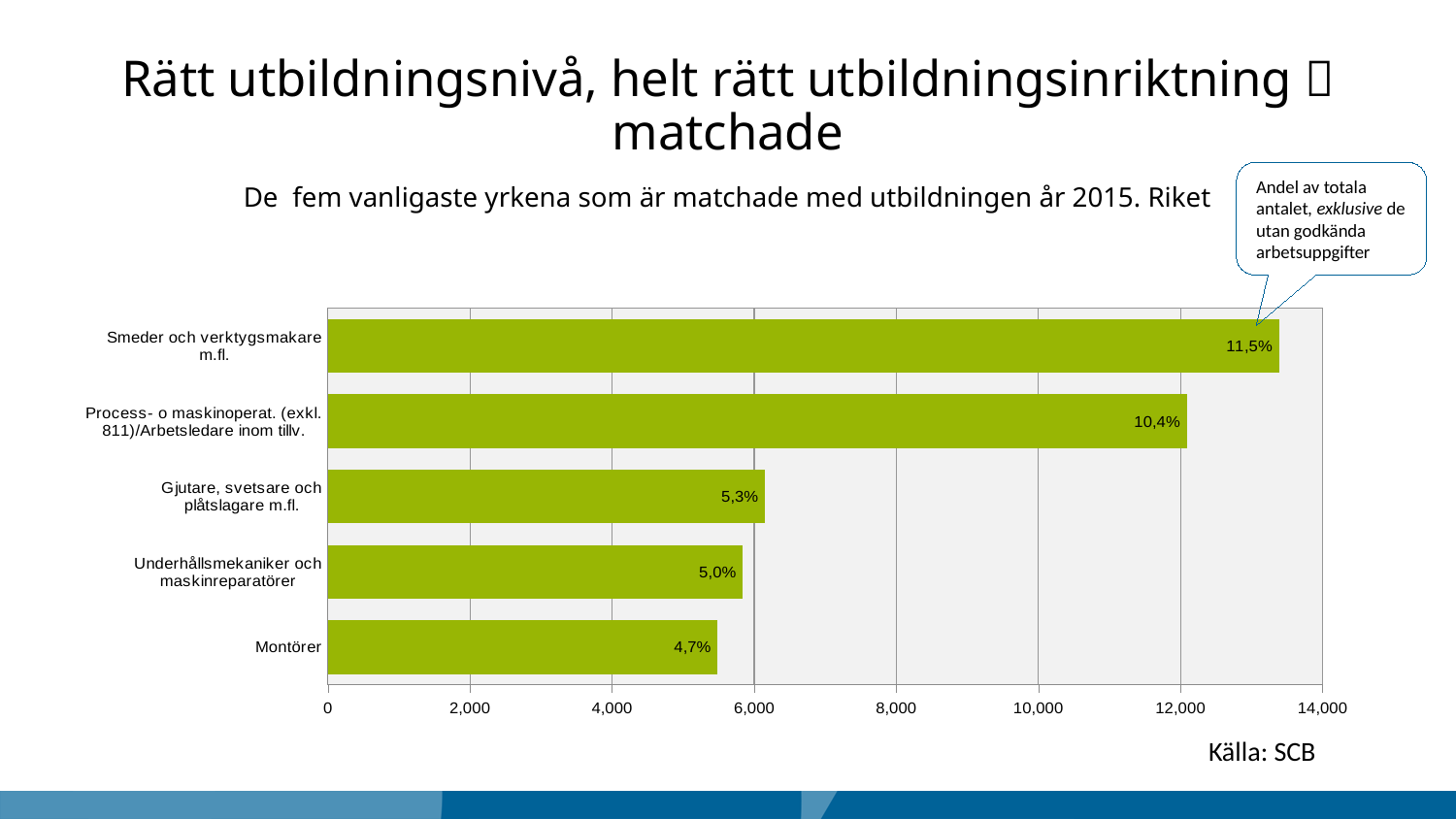
What percentage label is shown on the bar for Underhållsmekaniker och maskinreparatörer? 5,0% Which occupation has the longest bar in the chart? Smeder och verktygsmakare m.fl. What kind of chart is shown on the slide? Bar chart What percentage label is shown on the bar for Montörer? 4,7% How many occupations (categories) are shown in the chart? 5 Is the value for Montörer greater or less than 6,000? less What source is cited below the chart? SCB What percentage label is shown on the bar for Smeder och verktygsmakare m.fl.? 11,5% Which occupation has the shortest bar in the chart? Montörer Is the value for Smeder och verktygsmakare m.fl. greater or less than 12,000? greater Which has the larger value: Gjutare, svetsare och plåtslagare m.fl. or Underhållsmekaniker och maskinreparatörer? Gjutare, svetsare och plåtslagare m.fl. What percentage label is shown on the bar for Gjutare, svetsare och plåtslagare m.fl.? 5,3%